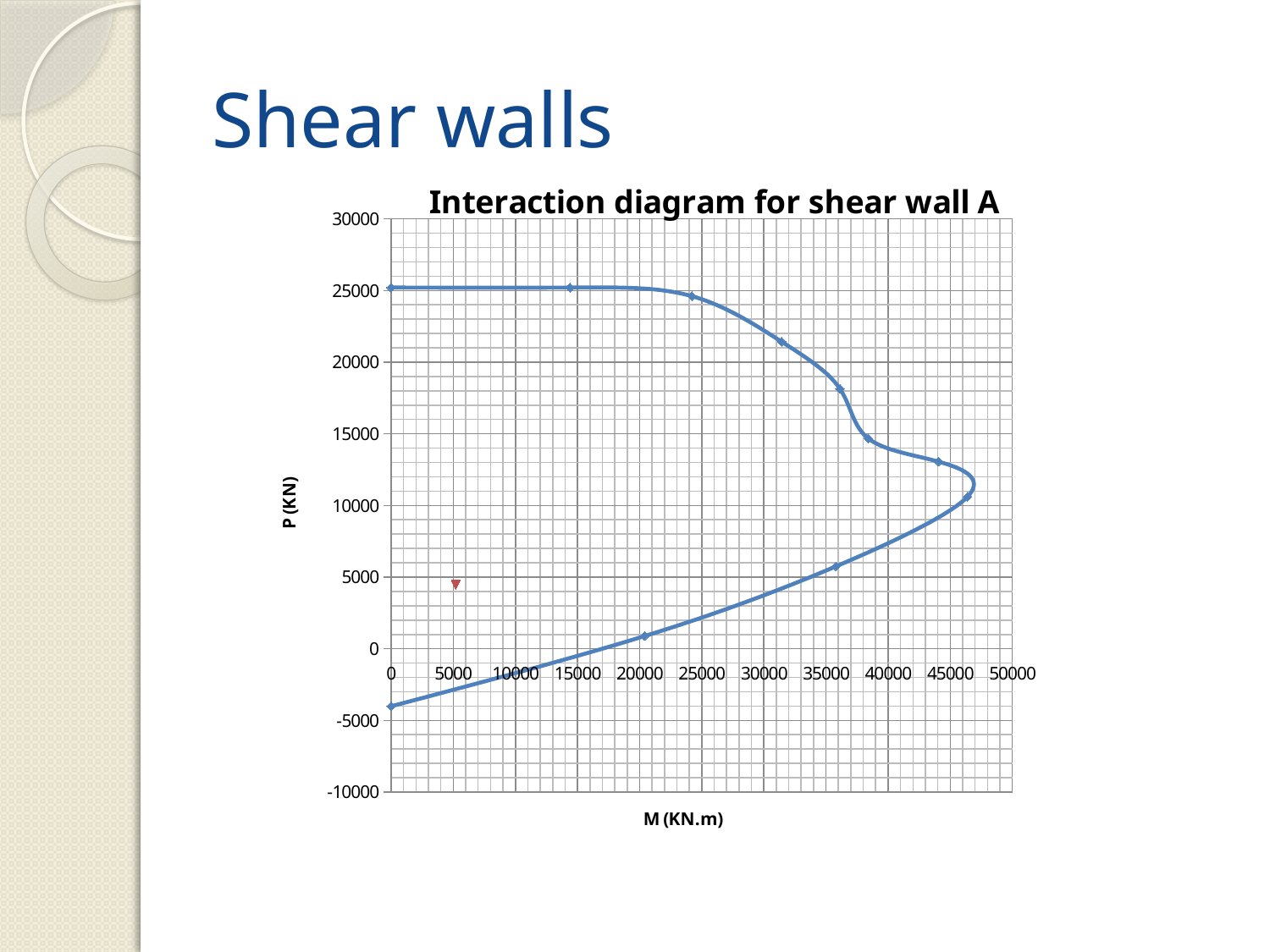
Is the lowest P value on the blue curve greater or less than -5000? greater What is the maximum value shown on the horizontal (M) axis? 50000 How many diamond markers are plotted on the blue curve? 11 Is the lowest P value on the blue curve greater or less than 0? less Is the P value of the red triangle marker greater or less than 5000? less What is the label of the vertical axis? P (KN) What kind of chart is shown on the slide? Line chart (scatter with smoothed line) What is the title of the chart? Interaction diagram for shear wall A